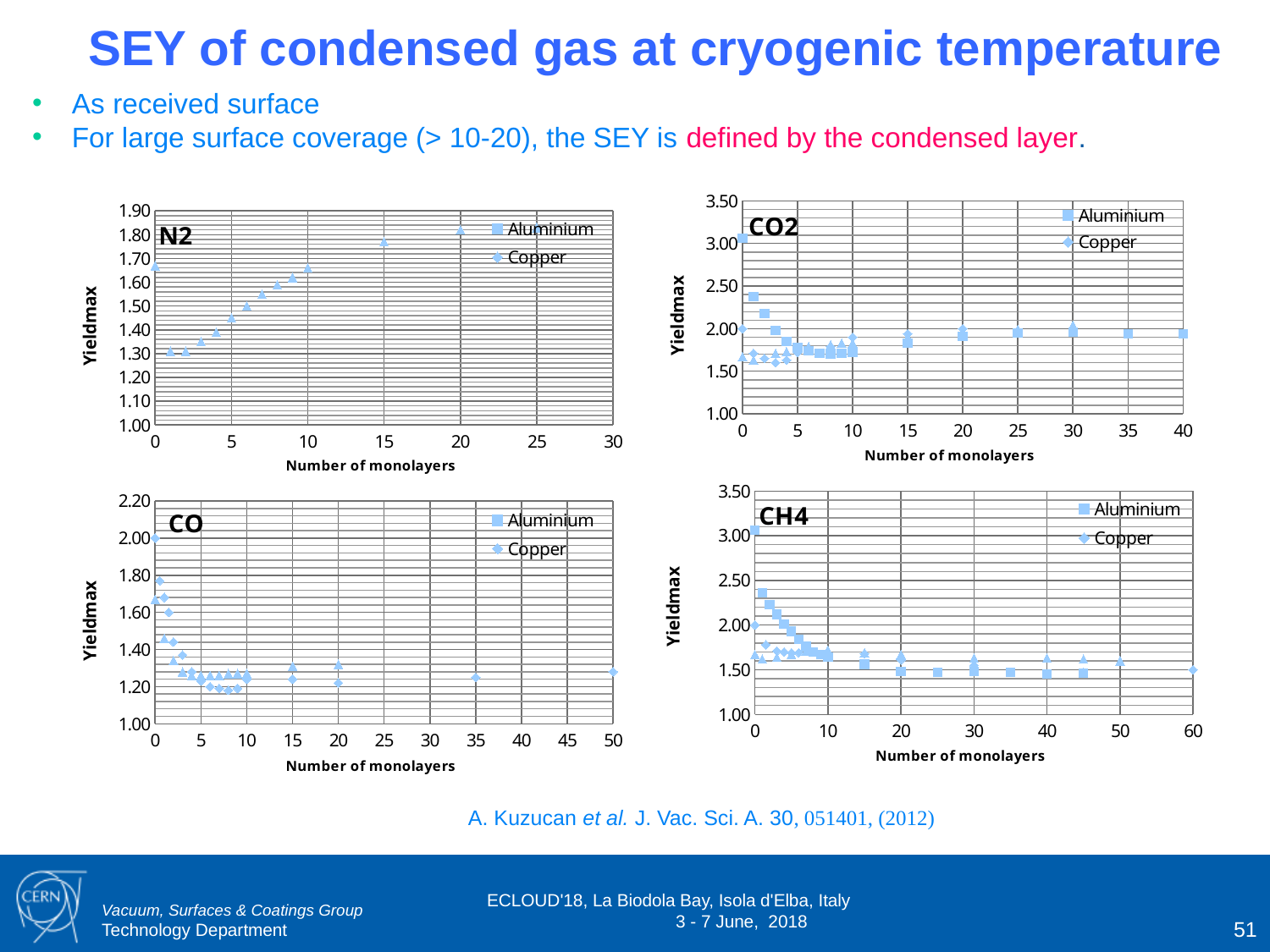
In the CO chart, is the value at 50 monolayers greater or less than 1.50? less What are the two series named in the legend of the CH4 chart? Aluminium and Copper In the CO2 chart, do the Aluminium values rise or fall as the number of monolayers increases from 0 to 10? fall What kind of chart is the N2 chart? scatter chart In the CH4 chart, do the Aluminium values rise or fall as the number of monolayers increases? fall How many series does the legend of the CO2 chart list? 2 How many charts are shown on the slide? 4 What is the label of the y axis on the CO chart? Yieldmax In the N2 chart, do the values rise or fall as the number of monolayers increases? rise In the CO2 chart, is the Aluminium value at 40 monolayers greater or less than 2.50? less In the CH4 chart, is the value at 60 monolayers greater or less than 2.00? less